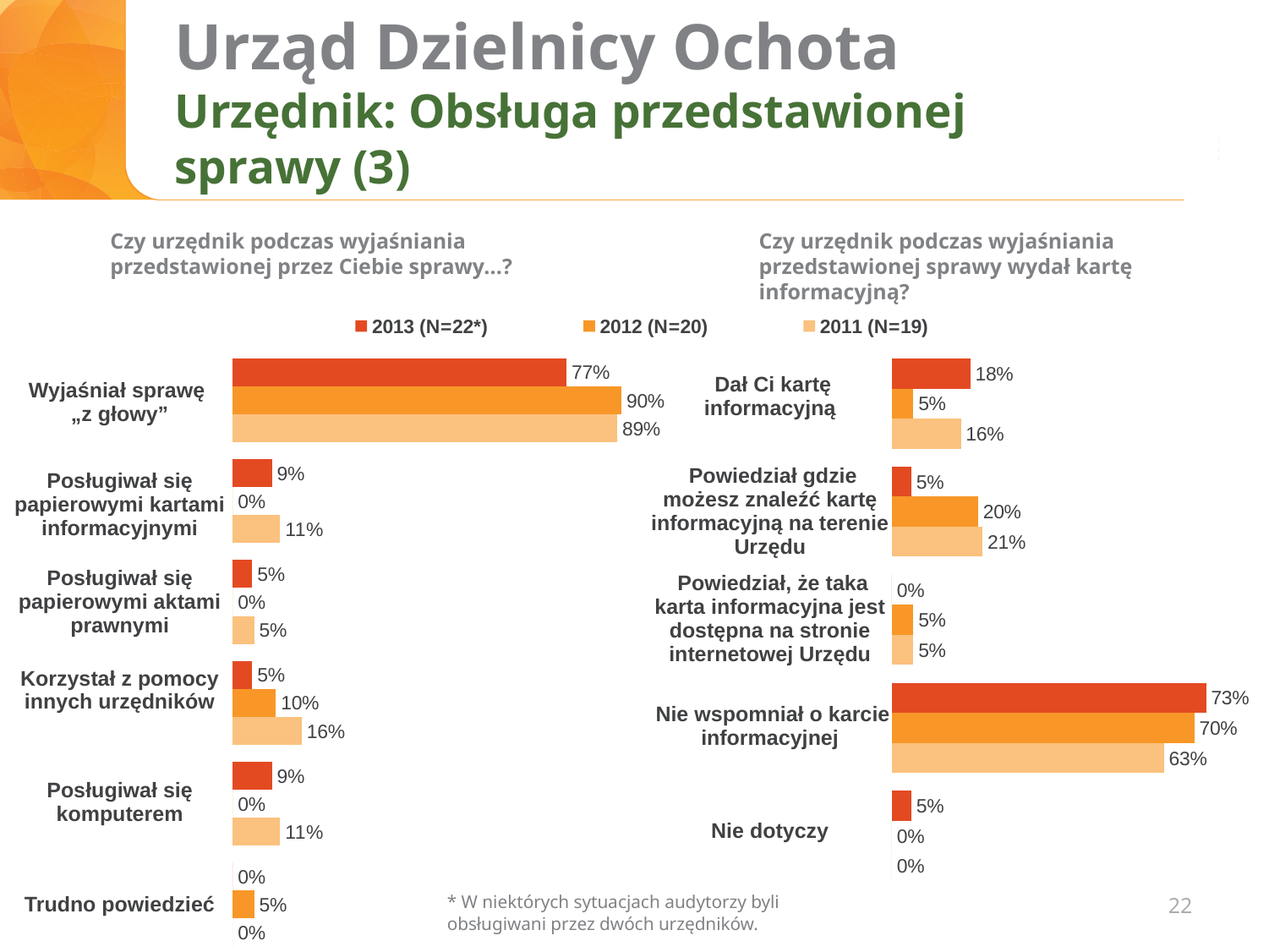
In the left chart, which category has the highest 2012 value? Wyjaśniał sprawę „z głowy” In the right chart, what is the 2011 value for "Nie wspomniał o karcie informacyjnej"? 63% How many categories does the left chart show? 6 In the left chart, what is the difference between the 2012 and 2013 values for "Wyjaśniał sprawę „z głowy”"? 13 percentage points In the right chart, which category has the lowest 2013 value? Powiedział, że taka karta informacyjna jest dostępna na stronie internetowej Urzędu In the left chart, what is the 2011 value for "Korzystał z pomocy innych urzędników"? 16% In the left chart, what is the 2013 value for "Wyjaśniał sprawę „z głowy”"? 77% How many series does the legend list? 3 In the right chart, what is the difference between the 2013 and 2011 values for "Nie wspomniał o karcie informacyjnej"? 10 percentage points What type of chart is the right chart? Bar chart In the right chart, for "Dał Ci kartę informacyjną", which year has the larger value: 2013 or 2011? 2013 In the right chart, what is the 2012 value for "Powiedział gdzie możesz znaleźć kartę informacyjną na terenie Urzędu"? 20%